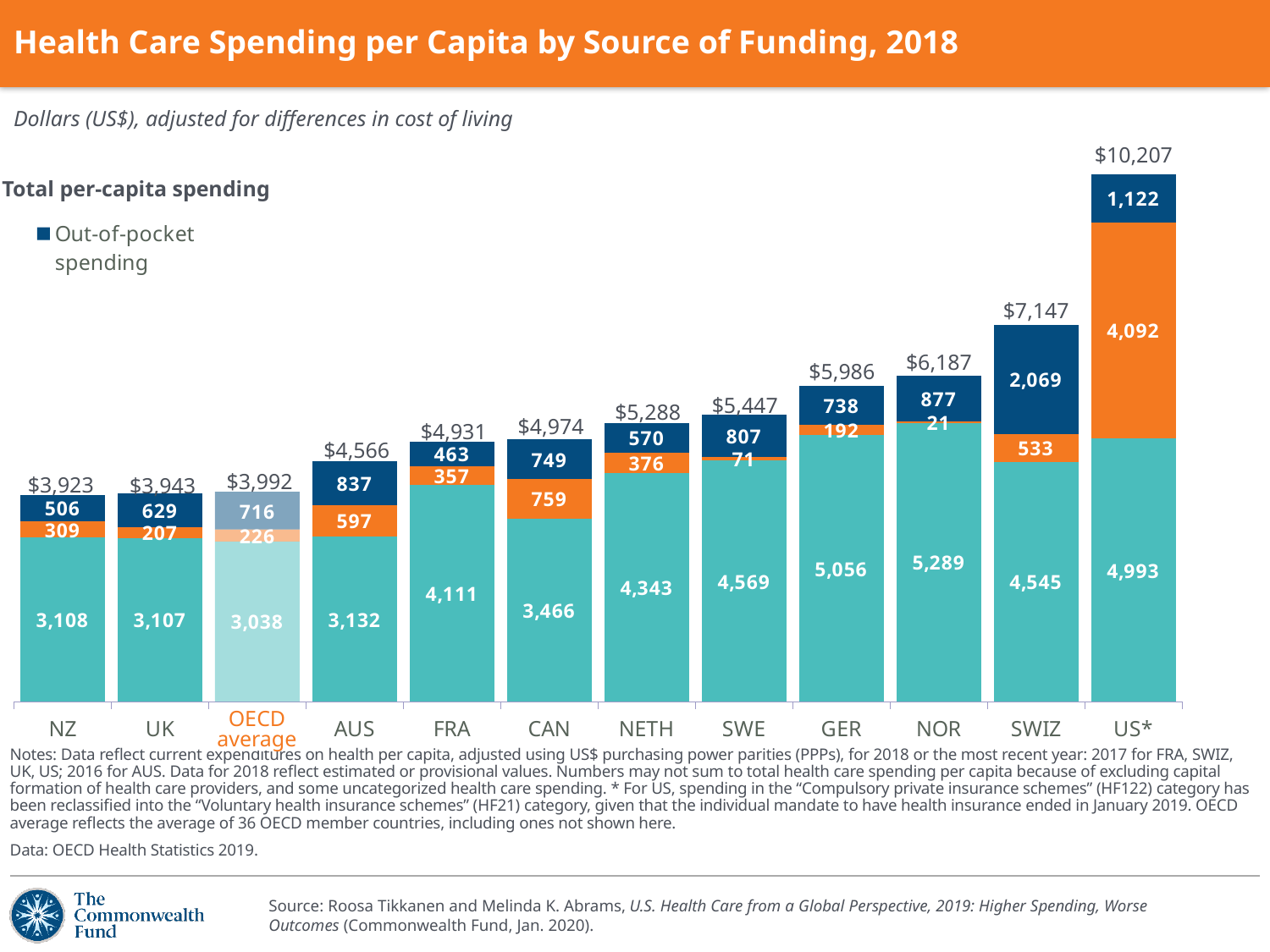
What is the total per-capita health care spending shown for the US? $10,207 Which country has the highest total per-capita health care spending? US What is the title of the chart? Health Care Spending per Capita by Source of Funding, 2018 Which has a larger out-of-pocket spending value, Germany (GER) or Norway (NOR)? Norway (NOR) What is the total per-capita spending shown for the OECD average? $3,992 What is the out-of-pocket spending value shown for Switzerland (SWIZ)? 2,069 How many countries or groups are shown along the x axis? 12 Which country has the lowest total per-capita health care spending? NZ Do the total per-capita spending values rise or fall moving from left to right along the x axis? Rise What is the value of the largest (bottom) segment of the Canada (CAN) bar? 3,466 What is the difference between the total per-capita spending of the US and Switzerland (SWIZ)? $3,060 What kind of chart is shown on the slide? Stacked bar chart